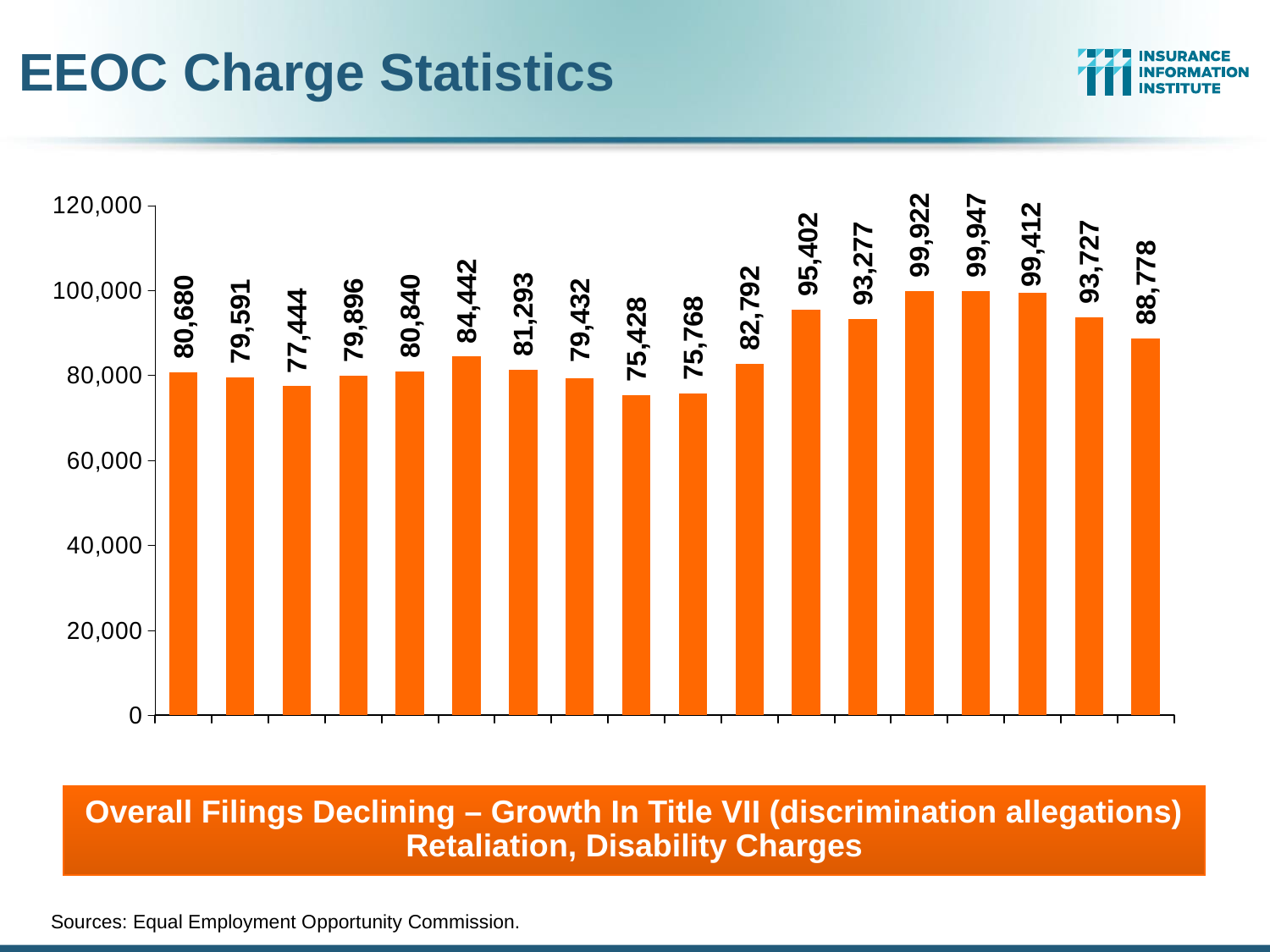
What source is cited for the chart data? Equal Employment Opportunity Commission Which is larger, the value of the first bar or the value of the last bar? the last bar (88,778) What is the title of the slide containing the chart? EEOC Charge Statistics What kind of chart is shown on the slide? bar chart Is the value of the rightmost bar greater or less than 100,000? less What is the value shown on the leftmost (first) bar? 80,680 What is the highest value labelled on any bar in the chart? 99,947 What is the difference between the two tallest bars, labelled 99,947 and 99,922? 25 How many bars are plotted in the chart? 18 What is the value shown on the rightmost (last) bar? 88,778 What is the difference between the last bar (88,778) and the first bar (80,680)? 8,098 What is the lowest value labelled on any bar in the chart? 75,428